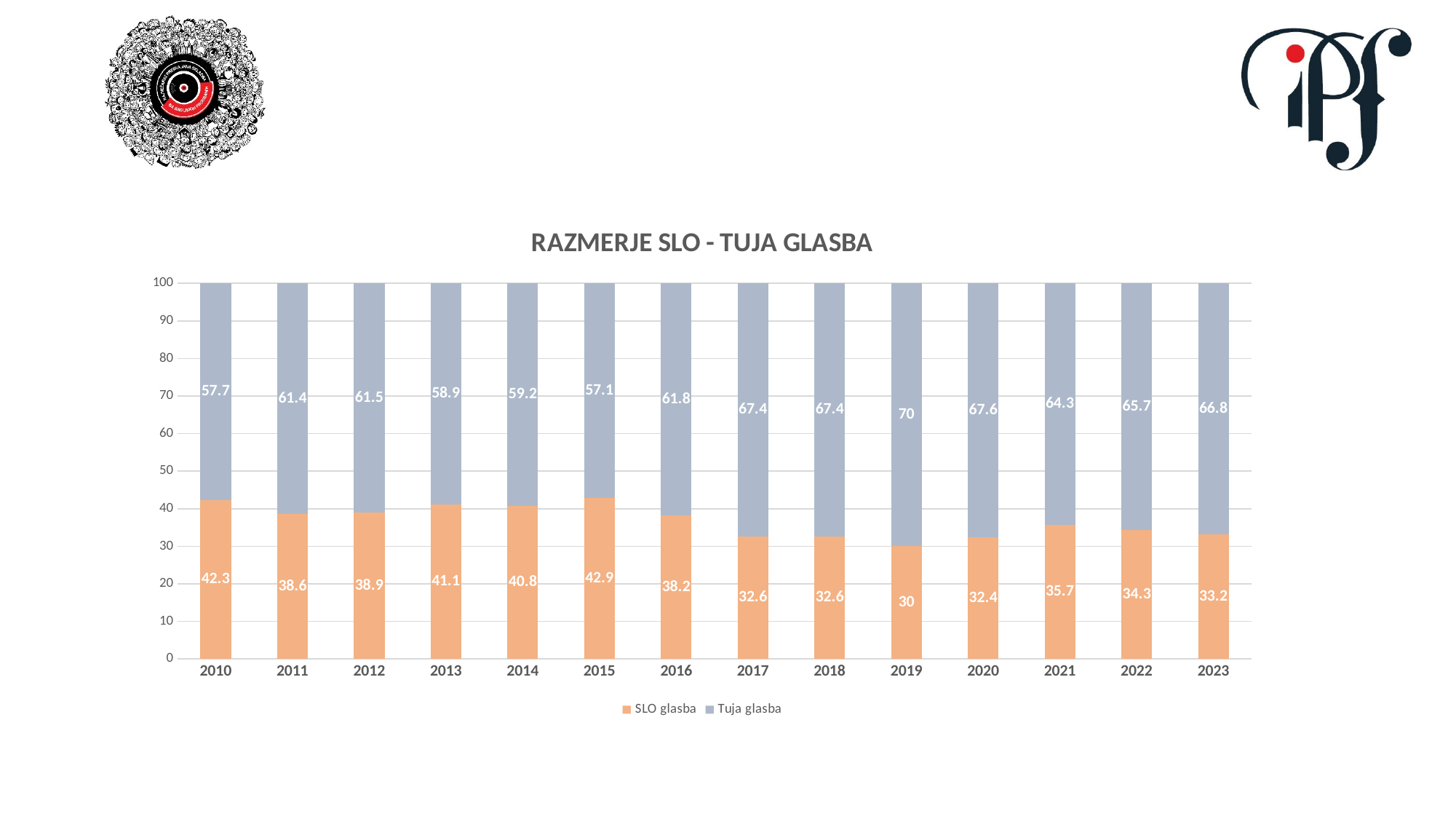
What is the value for SLO glasba in 2023? 33.2 Which year has the highest value for Tuja glasba? 2019 How many series does the legend list? 2 What is the difference between the Tuja glasba and SLO glasba values in 2021? 28.6 Which year has the lowest value for SLO glasba? 2019 Which year has the highest value for SLO glasba? 2015 What is the value for Tuja glasba in 2019? 70 Is the SLO glasba value for 2015 larger than the SLO glasba value for 2016? Yes What kind of chart is shown? Stacked bar chart How many years are shown on the x axis? 14 What is the value for SLO glasba in 2010? 42.3 What is the title of the chart? RAZMERJE SLO - TUJA GLASBA